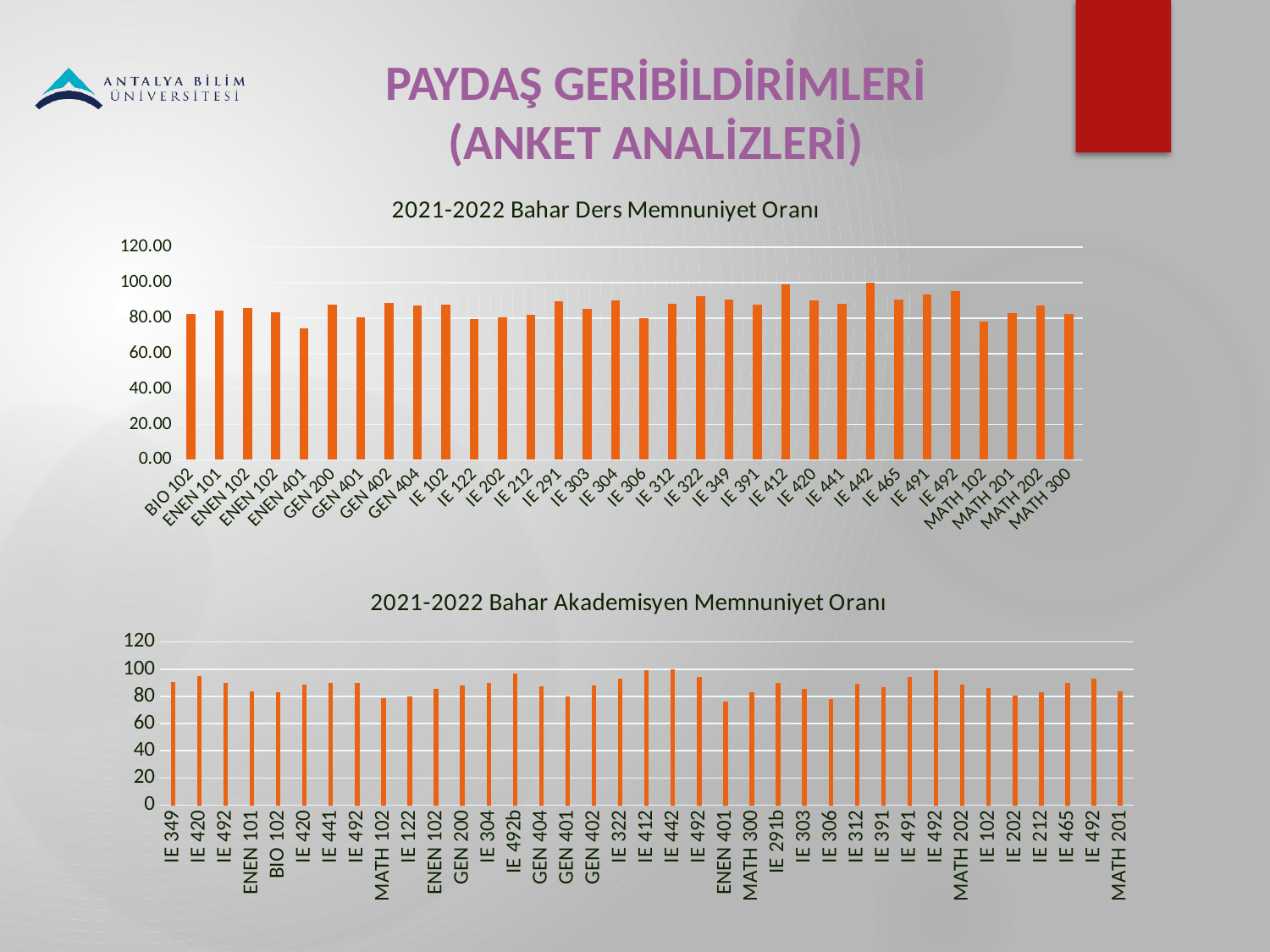
In the top chart '2021-2022 Bahar Ders Memnuniyet Oranı', which course has the lowest value? ENEN 401 In the bottom chart '2021-2022 Bahar Akademisyen Memnuniyet Oranı', is the value for ENEN 401 greater or less than 80? less What is the title of the bottom chart on the slide? 2021-2022 Bahar Akademisyen Memnuniyet Oranı In the bottom chart '2021-2022 Bahar Akademisyen Memnuniyet Oranı', is the value for IE 492b greater or less than 80? greater In the top chart '2021-2022 Bahar Ders Memnuniyet Oranı', which is larger, the value for IE 412 or the value for ENEN 401? IE 412 In the bottom chart '2021-2022 Bahar Akademisyen Memnuniyet Oranı', which is larger, the value for IE 322 or the value for ENEN 401? IE 322 In the top chart '2021-2022 Bahar Ders Memnuniyet Oranı', is the value for IE 412 greater or less than 80.00? greater What type of chart is the bottom chart titled '2021-2022 Bahar Akademisyen Memnuniyet Oranı'? bar chart How many bars are plotted in the top chart '2021-2022 Bahar Ders Memnuniyet Oranı'? 32 In the top chart '2021-2022 Bahar Ders Memnuniyet Oranı', which course has the highest value? IE 442 What type of chart is the top chart titled '2021-2022 Bahar Ders Memnuniyet Oranı'? bar chart